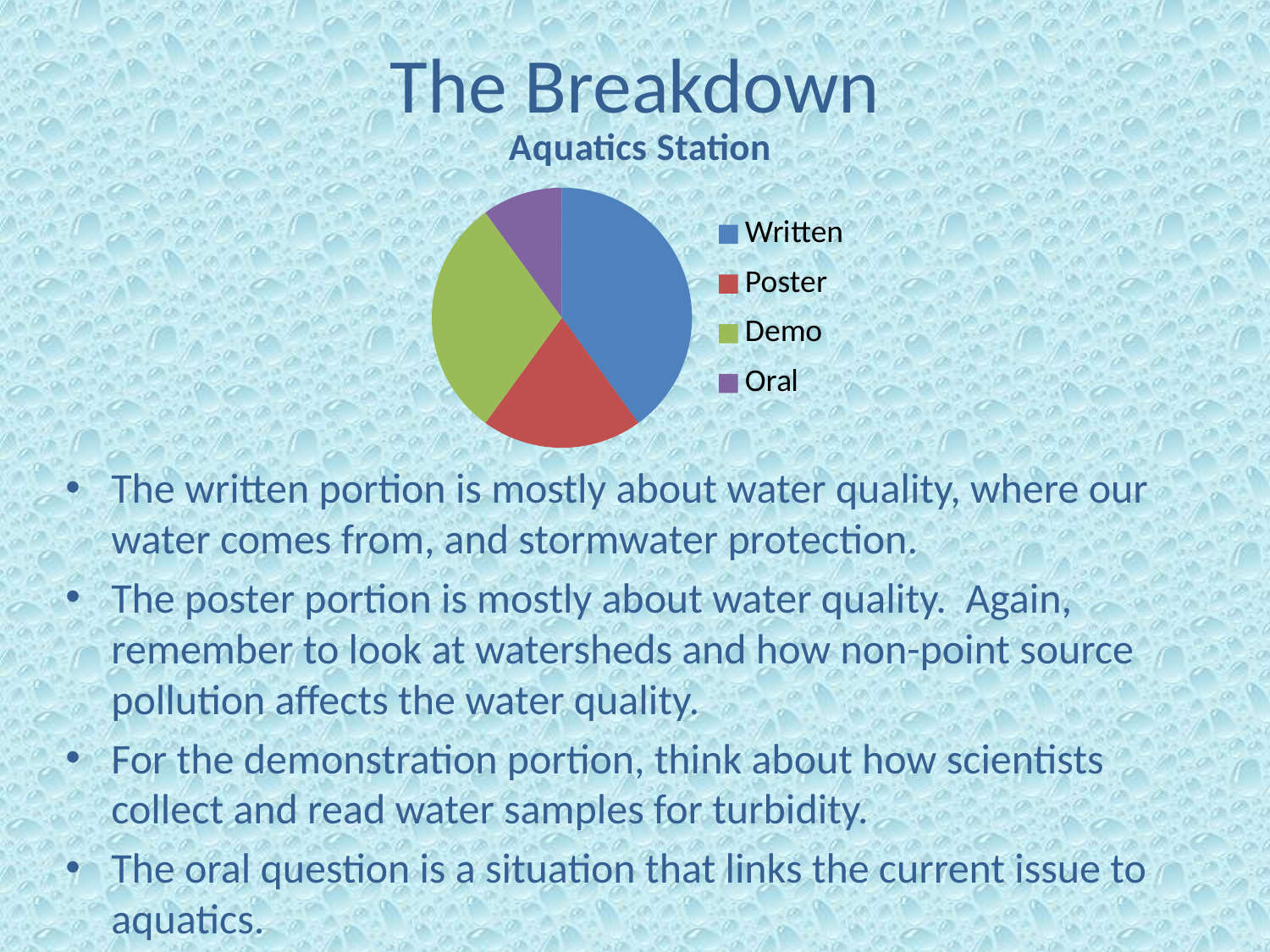
Which category has the smallest slice of the pie chart? Oral What is the title of the pie chart? Aquatics Station Which slice is larger in the pie chart, Written or Poster? Written How many slices does the pie chart have? 4 What kind of chart is shown on the slide? Pie chart How many entries does the legend of the pie chart list? 4 Which slice is larger in the pie chart, Written or Demo? Written What colour is the Demo slice in the pie chart? Green Which slice is larger in the pie chart, Demo or Oral? Demo Which category has the largest slice of the pie chart? Written